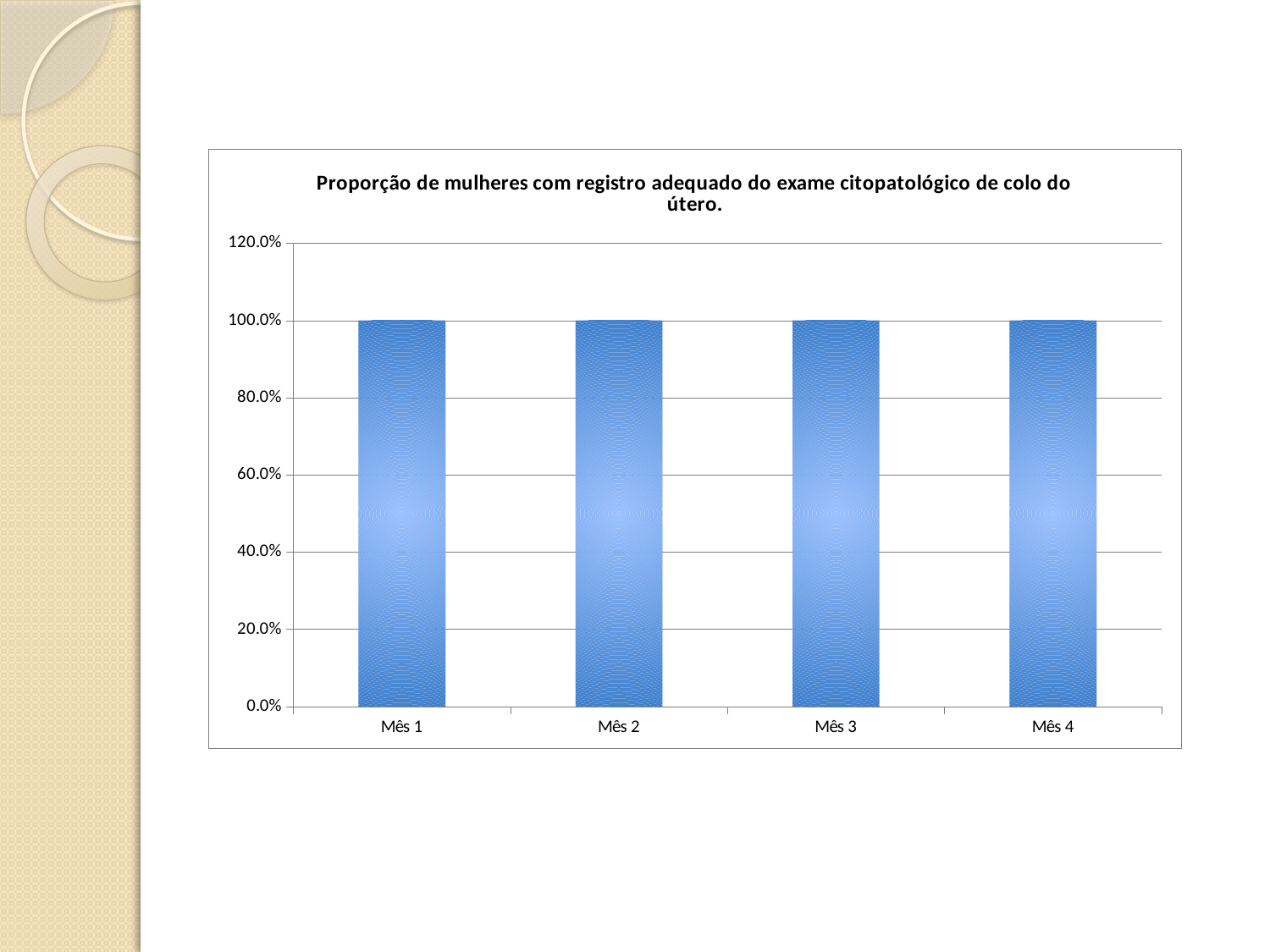
What kind of chart is shown on the slide? Bar chart What is the value for Mês 3? 100.0% Do the values rise, fall, or stay the same from Mês 1 to Mês 4? Stay the same What is the value for Mês 4? 100.0% What is the title of the chart? Proporção de mulheres com registro adequado do exame citopatológico de colo do útero. How many categories (months) are shown on the x axis of the chart? 4 What is the value for Mês 1? 100.0% What is the value for Mês 2? 100.0% What is the difference between the values for Mês 2 and Mês 3? 0.0% Is the value for Mês 1 greater or less than 80.0%? greater What is the highest value shown on the y axis of the chart? 120.0% Is the value for Mês 4 greater or less than 120.0%? less